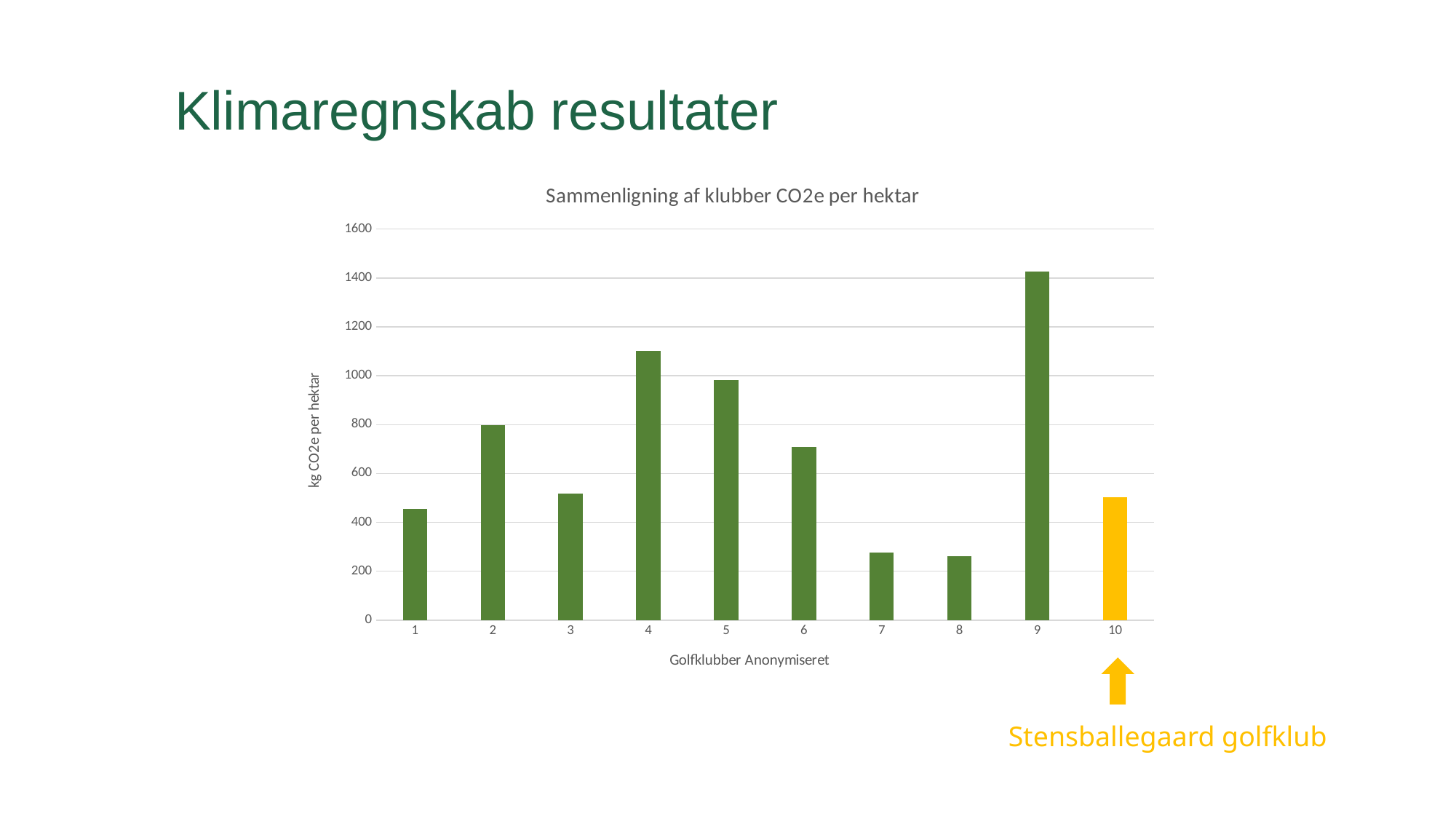
Is the value for golf club 7 greater or less than 400? less Which golf club has the highest CO2e per hektar? 9 Which golf club's bar is highlighted in yellow and labelled Stensballegaard golfklub? 10 Is the value for golf club 6 greater or less than 600? greater How many golf clubs (categories) are plotted on the x axis? 10 Which has a higher value, golf club 2 or golf club 6? 2 Which has a higher value, golf club 4 or golf club 5? 4 Is the value for golf club 9 greater or less than 1200? greater What kind of chart is shown on the slide? bar chart What is the title of the chart? Sammenligning af klubber CO2e per hektar